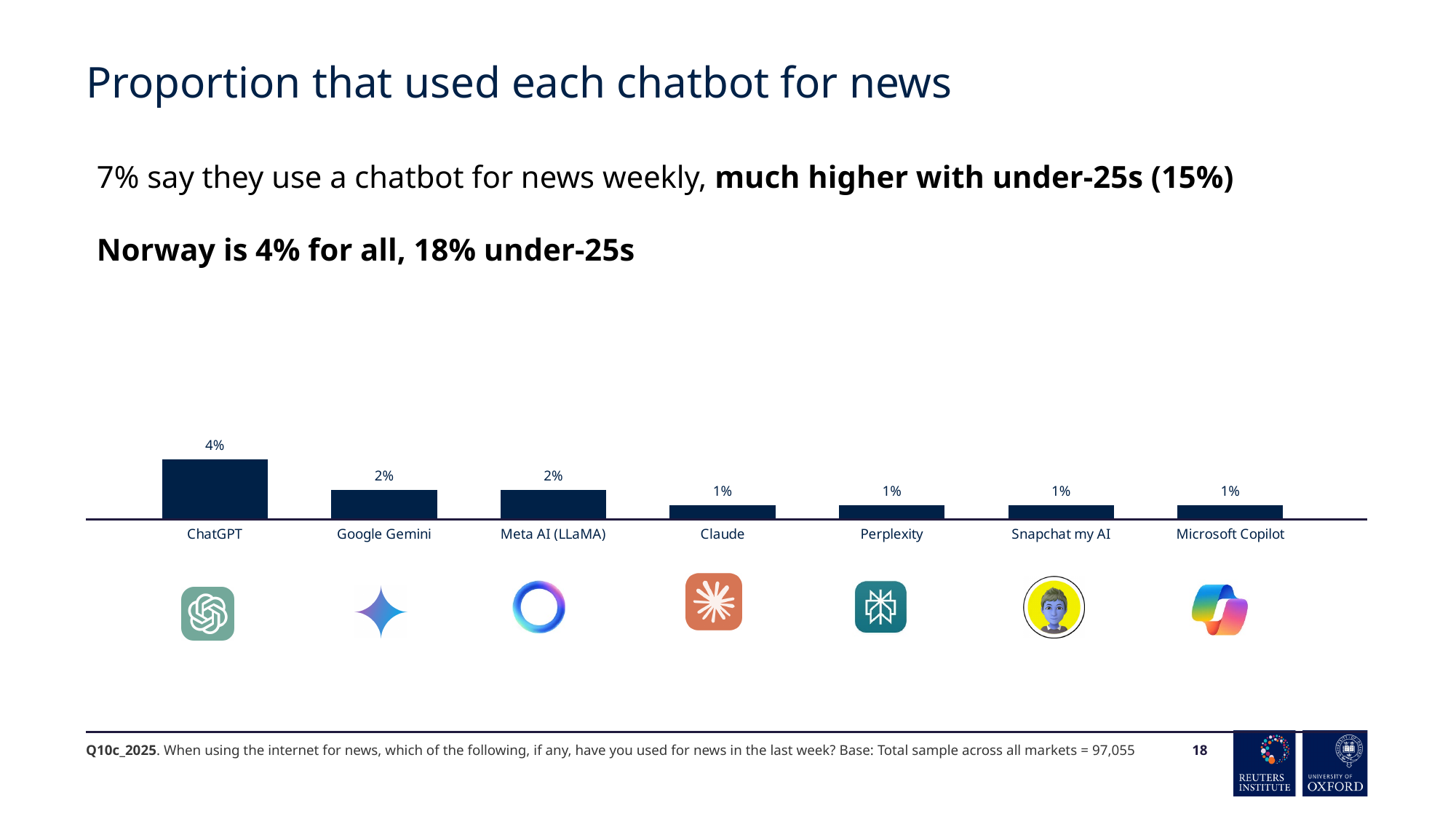
What percentage used Claude for news? 1% Which chatbot has the highest proportion of use for news? ChatGPT How many chatbots are shown in the chart? 7 What percentage used Microsoft Copilot for news? 1% What is the difference between the proportion for Google Gemini and the proportion for Perplexity? 1% What is the title of the chart on the slide? Proportion that used each chatbot for news Do the values rise or fall moving from left to right across the chart? Fall What is the difference between the proportion for ChatGPT and the proportion for Meta AI (LLaMA)? 2% What kind of chart is shown on the slide? Bar chart What percentage used Google Gemini for news? 2% Which is larger, the proportion for ChatGPT or the proportion for Snapchat my AI? ChatGPT What percentage used ChatGPT for news? 4%